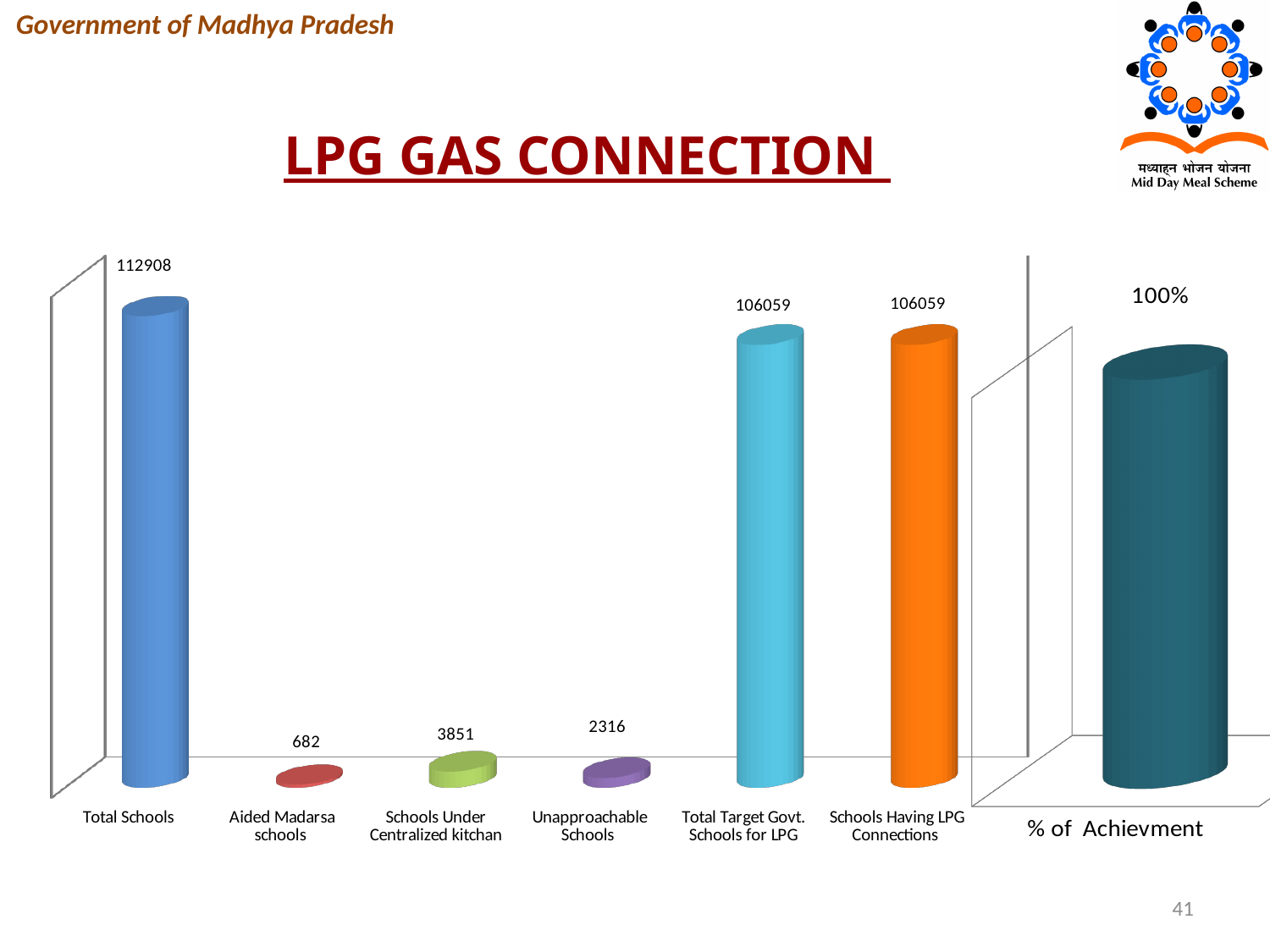
In the left chart, what is the value for Aided Madarsa schools? 682 In the left chart, what is the value for Unapproachable Schools? 2316 In the left chart, what is the difference between Total Schools and Total Target Govt. Schools for LPG? 6849 In the right chart, what is the value shown for % of Achievment? 100% In the left chart, what is the value for Total Schools? 112908 In the left chart, what is the value for Schools Having LPG Connections? 106059 What is the title of the slide's chart section? LPG GAS CONNECTION How many categories are shown in the left chart? 6 In the left chart, which category has the highest value? Total Schools In the left chart, what is the value for Schools Under Centralized kitchan? 3851 In the left chart, which is larger: Schools Under Centralized kitchan or Unapproachable Schools? Schools Under Centralized kitchan In the left chart, which category has the lowest value? Aided Madarsa schools